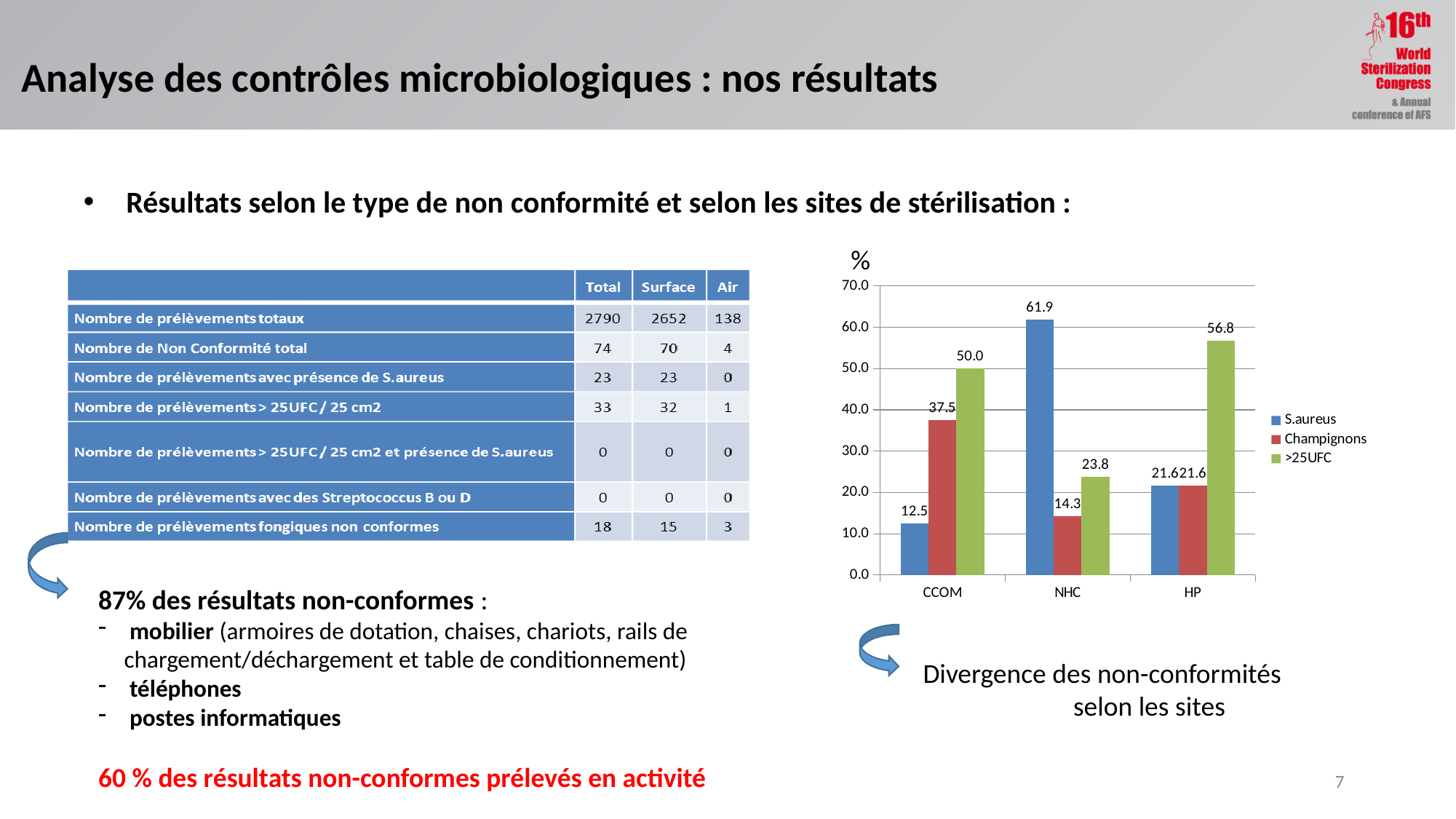
How many series does the chart legend list? 3 Which is larger at HP: the S.aureus value or the >25UFC value? >25UFC What is the value for Champignons at CCOM? 37.5 How many sites are shown on the x axis of the chart? 3 What is the difference between the >25UFC value and the S.aureus value at CCOM? 37.5 Which site has the highest value for S.aureus? NHC Which site has the lowest value for >25UFC? NHC What is the value for S.aureus at NHC? 61.9 What kind of chart is shown on the slide? bar chart Is the value for Champignons at HP greater or less than 30.0? less What is the value for Champignons at NHC? 14.3 What is the value for >25UFC at HP? 56.8